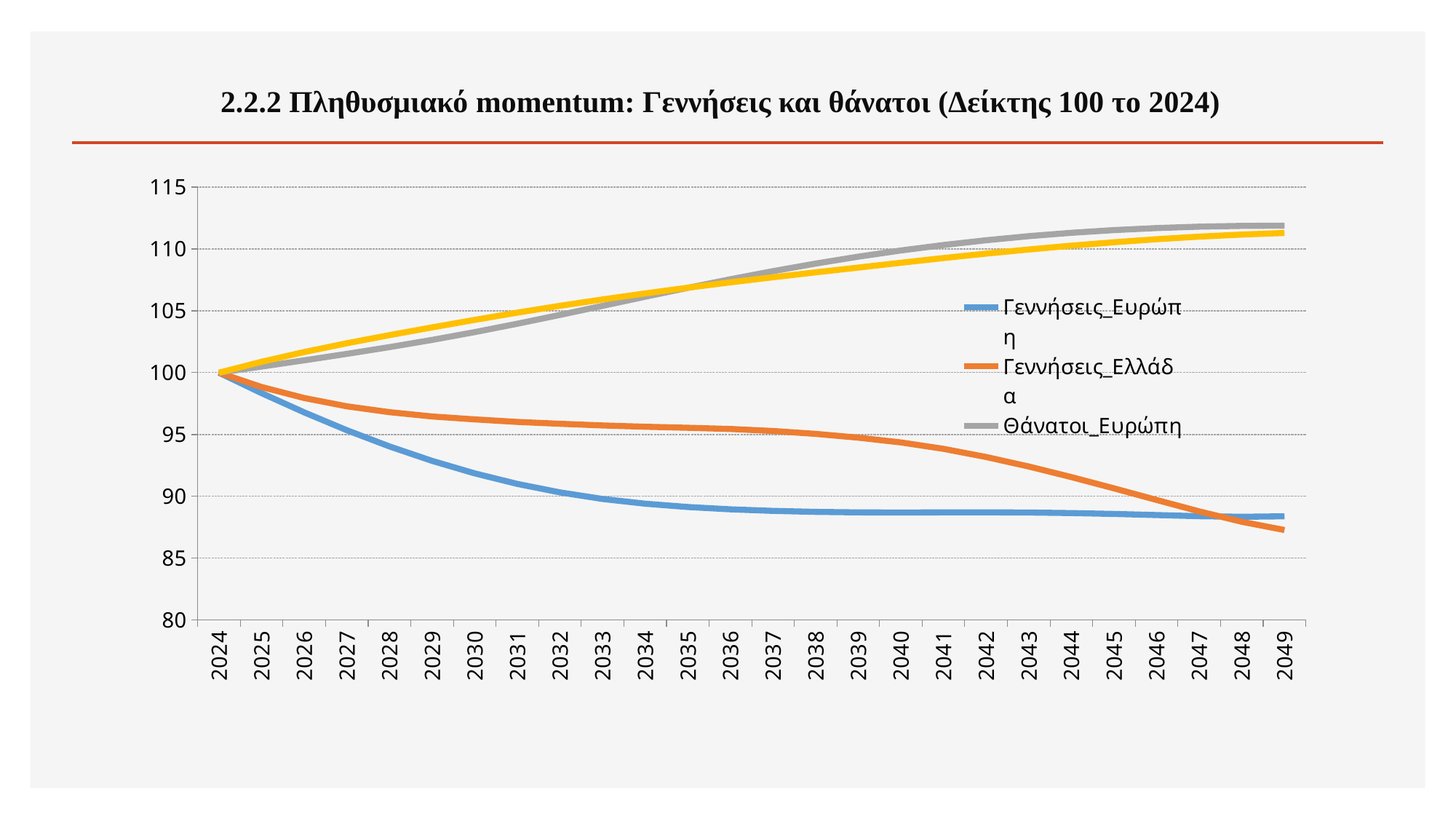
In 2040, which is higher: Γεννήσεις_Ευρώπη or Γεννήσεις_Ελλάδα? Γεννήσεις_Ελλάδα Is the value for Θάνατοι_Ευρώπη in 2049 greater or less than 110? greater Does the Θάνατοι_Ευρώπη line rise or fall from 2024 to 2049? rise How many series does the legend list? 3 Is the value for Γεννήσεις_Ευρώπη in 2049 greater or less than 90? less What is the value of Γεννήσεις_Ευρώπη in 2024? 100 What colour is the Θάνατοι_Ευρώπη line? grey Is the value for Γεννήσεις_Ελλάδα in 2030 greater or less than 95? greater How many years are shown on the x axis? 26 Does the Γεννήσεις_Ευρώπη line rise or fall from 2024 to 2049? fall What kind of chart is shown on the slide? line chart What is the value of Θάνατοι_Ευρώπη in 2024? 100